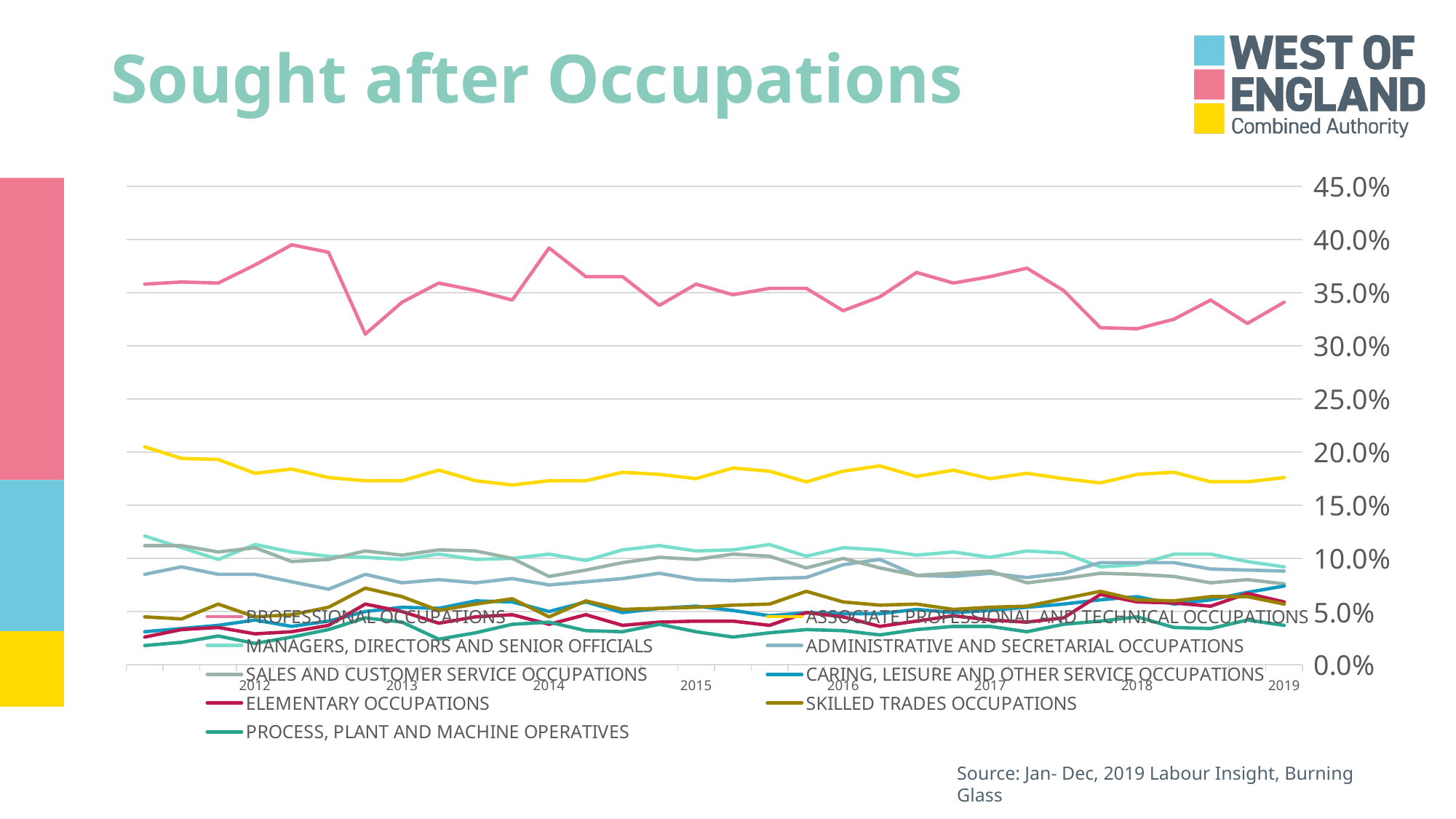
Does the Associate Professional and Technical Occupations line rise or fall overall from 2012 to 2019? fall Is the value for Managers, Directors and Senior Officials at the start of 2012 greater or less than 15.0%? less Which occupation series has the highest values across the whole chart? Professional Occupations Is the value for Process, Plant and Machine Operatives at the start of 2012 greater or less than 5.0%? less Which occupation series has the second-highest values across the chart? Associate Professional and Technical Occupations Which is larger at the end of 2019: Professional Occupations or Associate Professional and Technical Occupations? Professional Occupations What is the title of the slide containing the chart? Sought after Occupations How many series does the legend list? 9 Is the value for Professional Occupations at the start of 2012 greater or less than 30.0%? greater Does the Caring, Leisure and Other Service Occupations line rise or fall overall from 2012 to 2019? rise What kind of chart is shown on the slide? line chart